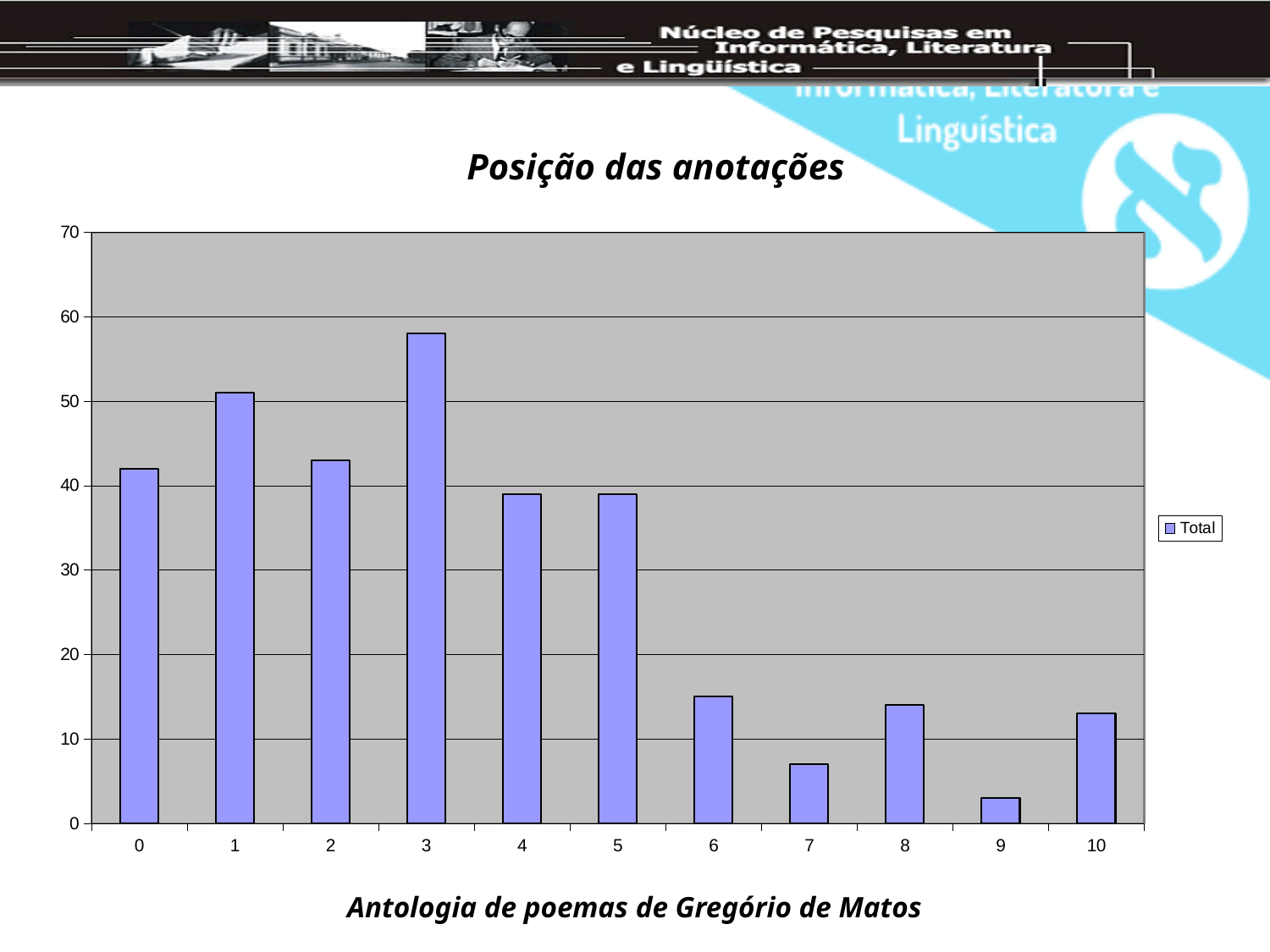
What is the name of the series shown in the legend? Total Which category has the lowest value? 9 Which has the larger value, category 1 or category 2? 1 Is the value for category 9 greater or less than 10? less What is the title of the chart? Posição das anotações How many categories are shown on the x axis? 11 What kind of chart is shown on the slide? bar chart Is the value for category 4 greater or less than 30? greater Is the value for category 3 greater or less than 50? greater Which has the larger value, category 7 or category 10? 10 Which category has the highest value? 3 How many series does the legend list? 1